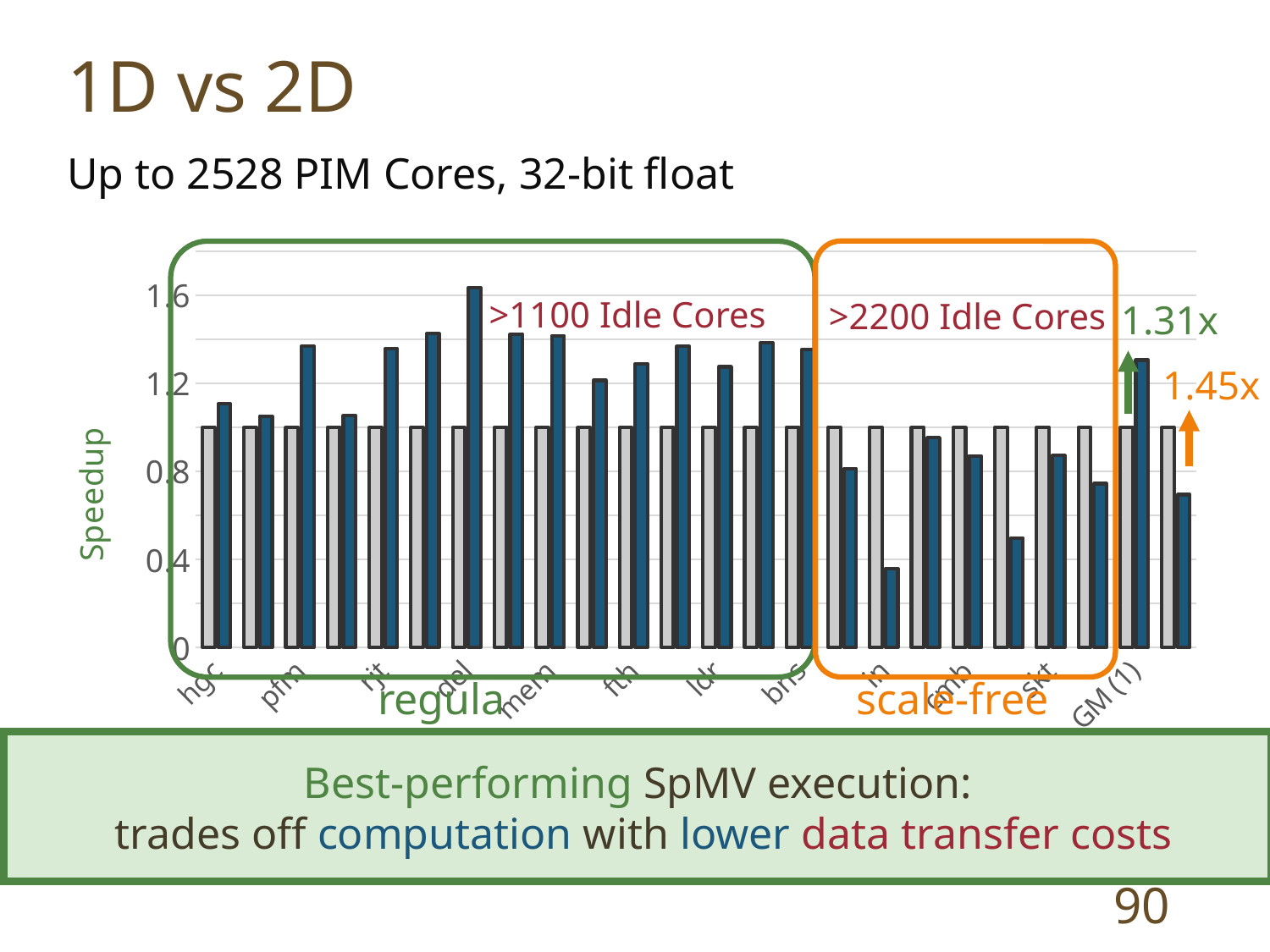
What speedup value is annotated in green next to the GM bars? 1.31x Which has the taller blue bar, hgc or pfm? pfm Is the shortest blue bar in the regular group or the scale-free group? scale-free Is the blue bar for pfm greater or less than 1.2? greater Is the blue bar for mem greater or less than 1.2? greater What are the two group labels shown beneath the chart's x-axis? regular and scale-free What is the label on the y-axis of the chart? Speedup What type of chart is shown on the slide? bar chart Is the blue bar for bns greater or less than 1.2? greater Is the tallest blue bar in the regular group or the scale-free group? regular